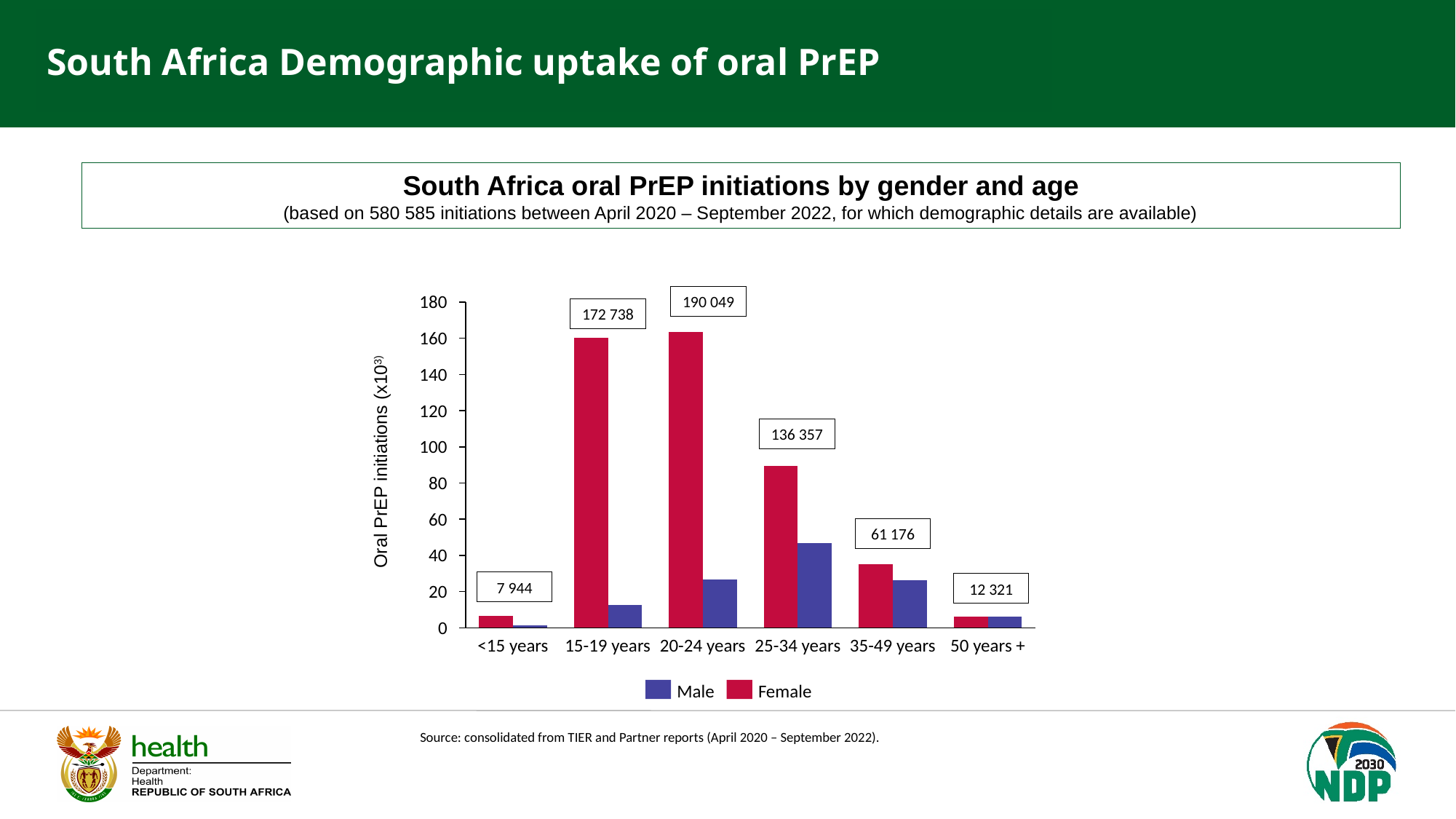
Which age group has the lowest labelled total of oral PrEP initiations? <15 years Is the Female bar for the 25-34 years age group greater or less than 80 on the y axis? greater Which is larger for the 15-19 years age group, the Male bar or the Female bar? Female What kind of chart is shown on the slide? Bar chart How many age categories are shown on the x axis? 6 What total number of oral PrEP initiations is labelled for the 20-24 years age group? 190 049 How many series does the legend list? 2 What total number of oral PrEP initiations is labelled for the 35-49 years age group? 61 176 Which colour represents the Male series in the legend? Blue What is the difference between the labelled totals for the 20-24 years and 15-19 years age groups? 17 311 Which age group has the highest labelled total of oral PrEP initiations? 20-24 years What total number of oral PrEP initiations is labelled for the <15 years age group? 7 944